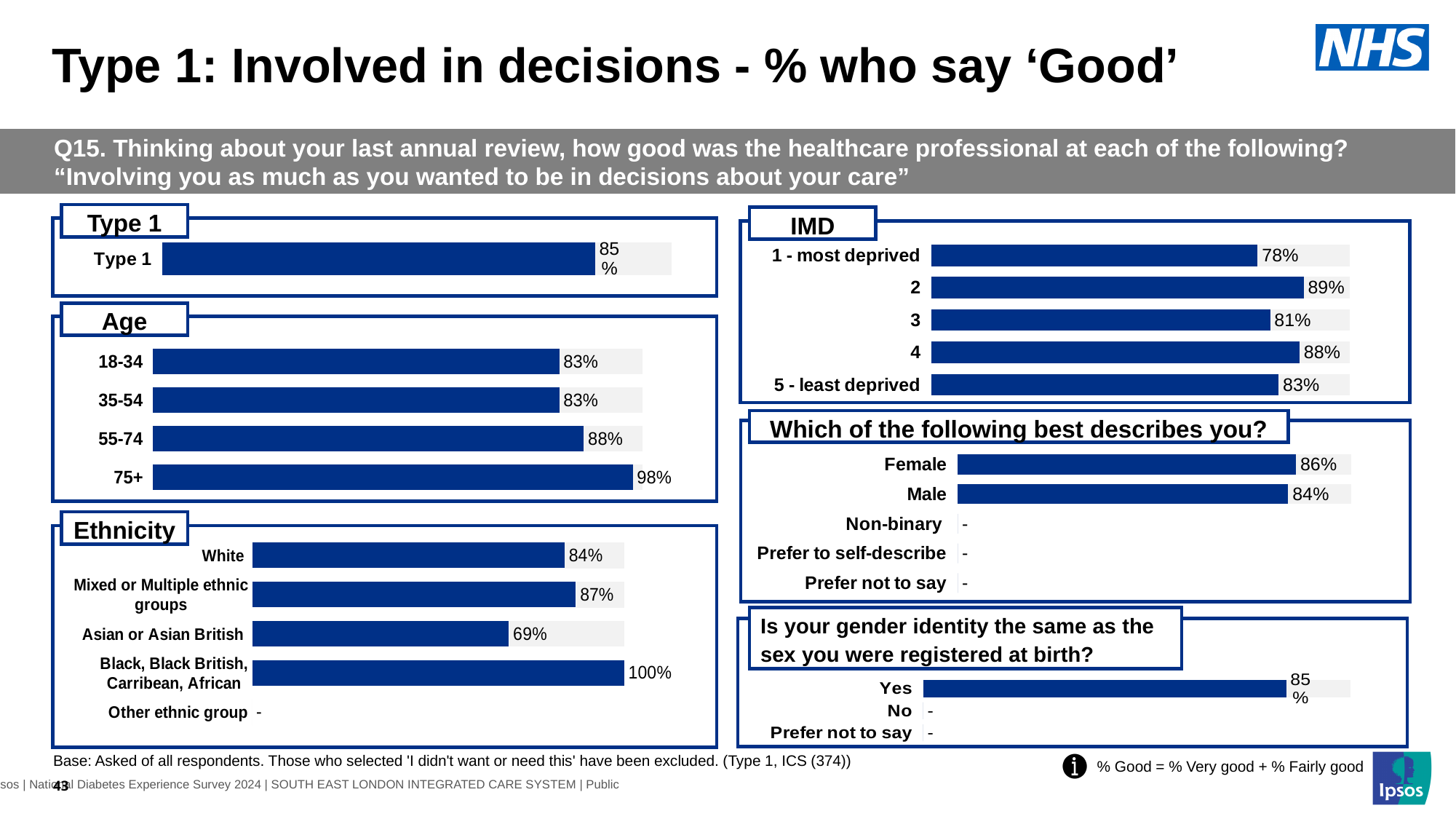
In the IMD chart, what is the difference between the values for 2 and 1 - most deprived? 11 percentage points In the 'Is your gender identity the same as the sex you were registered at birth?' chart, what is the value for Yes? 85% In the Ethnicity chart, which group has the lowest value among those with a bar shown? Asian or Asian British In the 'Which of the following best describes you?' chart, what is the value for Male? 84% In the 'Which of the following best describes you?' chart, which is larger, Female or Male? Female How many age groups are shown in the Age chart? 4 In the Age chart, what is the value for 75+? 98% What kind of chart is the IMD chart? Bar chart In the IMD chart, what is the value for 1 - most deprived? 78% In the Ethnicity chart, what is the value for Asian or Asian British? 69% In the IMD chart, which category has the highest value? 2 In the Age chart, which age group has the highest value? 75+